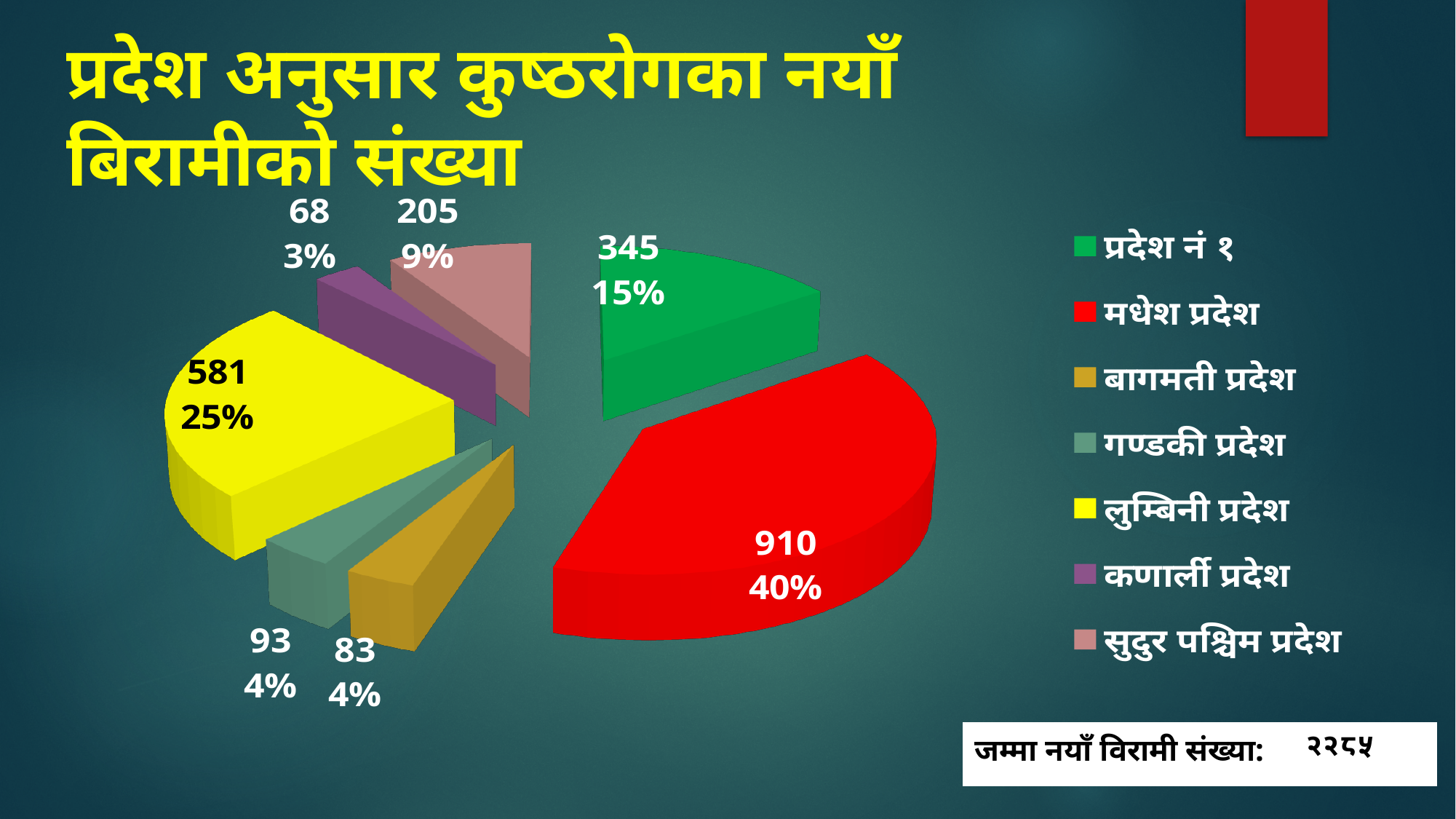
What is the value for कर्णाली प्रदेश? 68 Which is larger, the value for प्रदेश नं १ or the value for सुदुर पश्चिम प्रदेश? प्रदेश नं १ What is the value for लुम्बिनी प्रदेश? 581 What kind of chart is shown on the slide? pie chart What is the value for प्रदेश नं १? 345 How many entries does the legend list? 7 Which province has the largest slice of the pie? मधेश प्रदेश What is the value for मधेश प्रदेश? 910 Which province has the smallest slice of the pie? कर्णाली प्रदेश How many slices does the pie chart have? 7 What share of the pie does सुदुर पश्चिम प्रदेश represent? 9% What is the difference between the values for मधेश प्रदेश and लुम्बिनी प्रदेश? 329